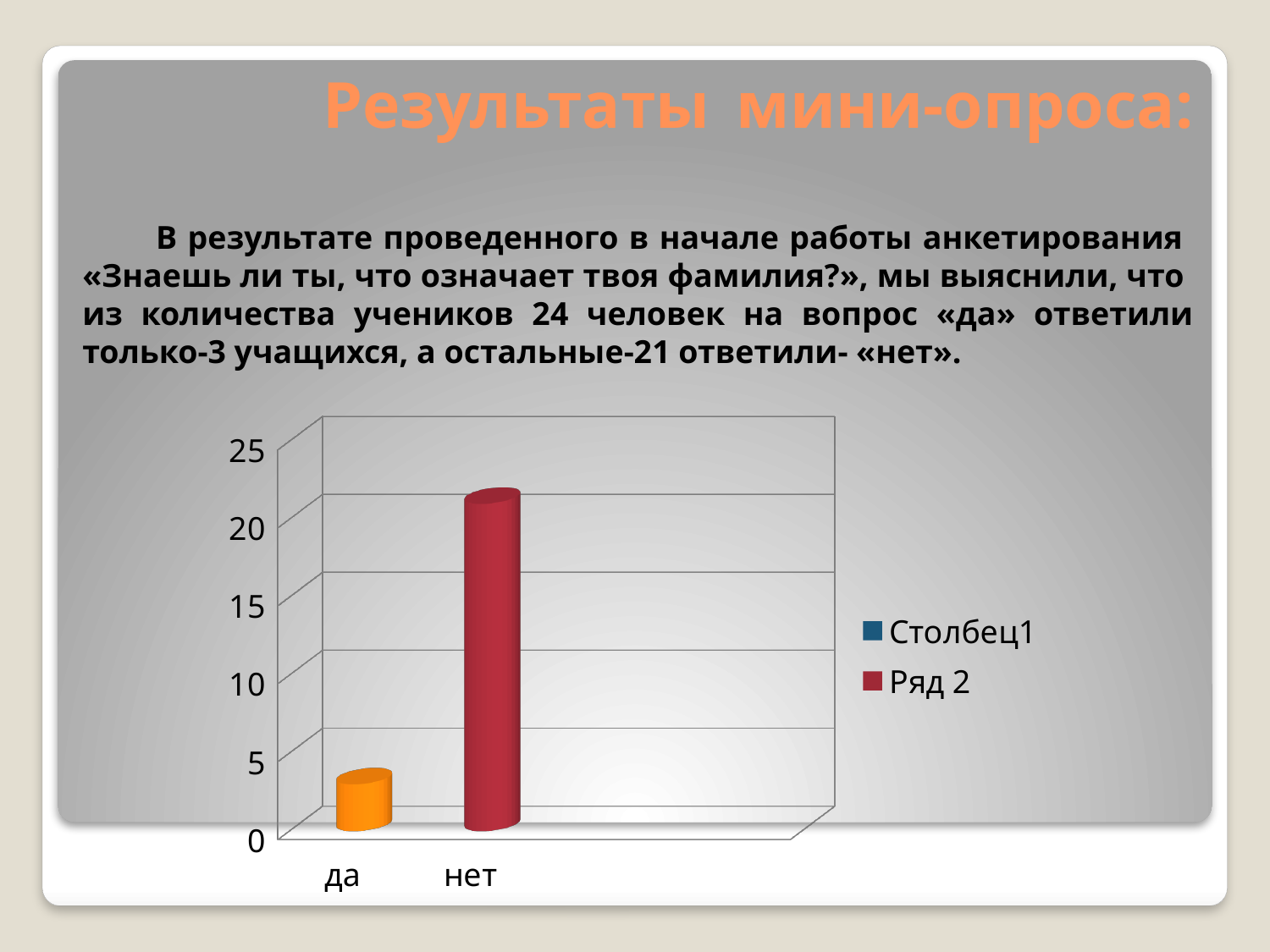
What kind of chart is shown on the slide? bar chart How many series does the chart legend list? 2 How many categories are shown on the x axis of the chart? 2 Which category has the highest bar in the chart? нет Is the value for "нет" greater or less than 25? less Which category has the lowest bar in the chart? да What is the highest tick value shown on the vertical axis of the chart? 25 What are the two entries listed in the chart legend? Столбец1, Ряд 2 Is the value for "да" greater or less than 10? less Which bar is taller, "да" or "нет"? нет Is the value for "нет" greater or less than 20? greater